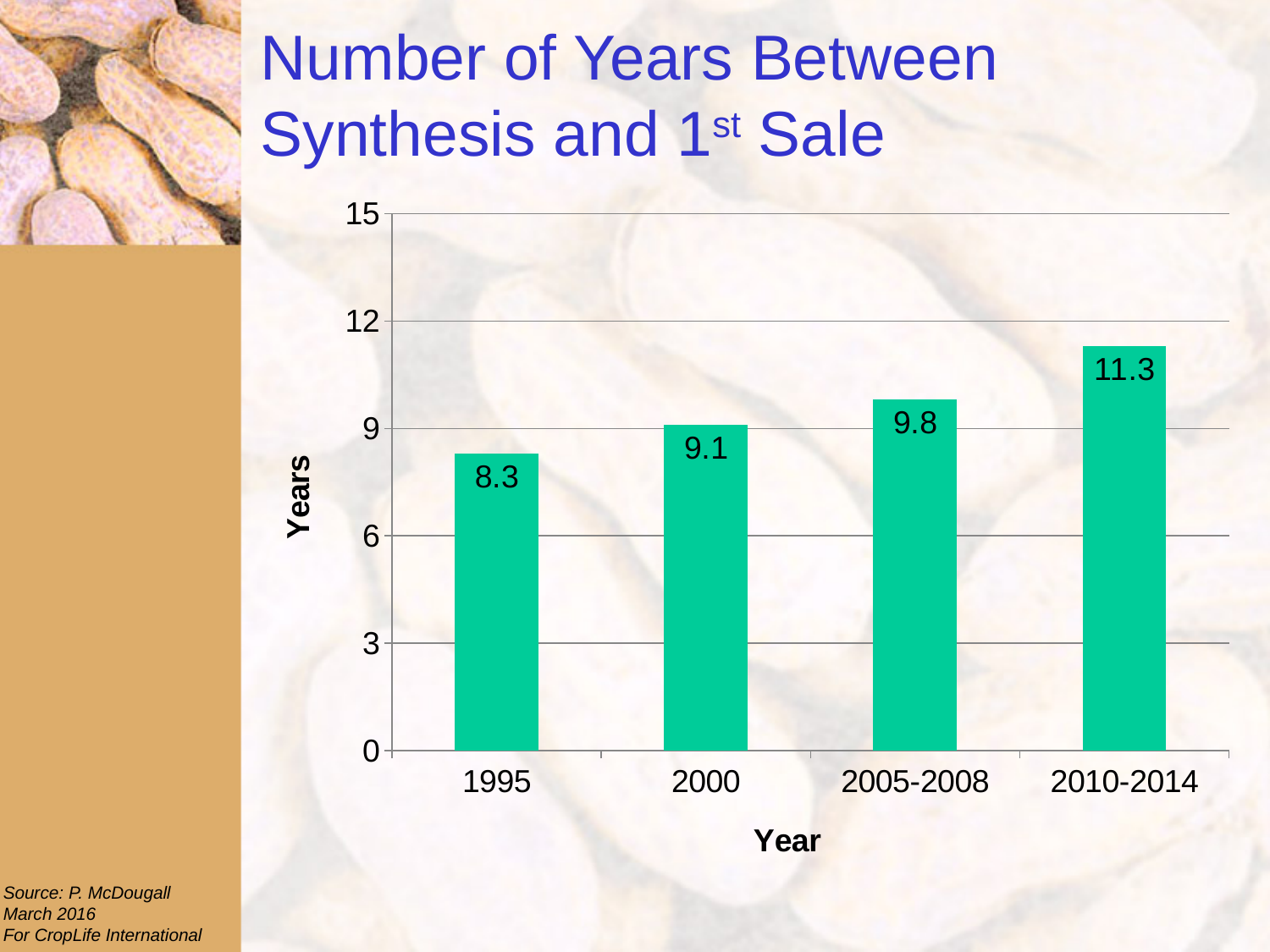
How many periods are shown on the x axis? 4 What is the number of years between synthesis and first sale for 1995? 8.3 What kind of chart is shown on the slide? Bar chart What is the value shown for 2005-2008? 9.8 What is the difference in years between 2010-2014 and 1995? 3.0 Which period has the highest number of years between synthesis and first sale? 2010-2014 Do the values rise or fall from 1995 to 2010-2014? Rise Which is larger, the value for 2000 or the value for 2005-2008? 2005-2008 What is the difference in years between 2005-2008 and 2000? 0.7 Which period has the lowest number of years between synthesis and first sale? 1995 What is the value shown for 2010-2014? 11.3 What is the value shown for 2000? 9.1